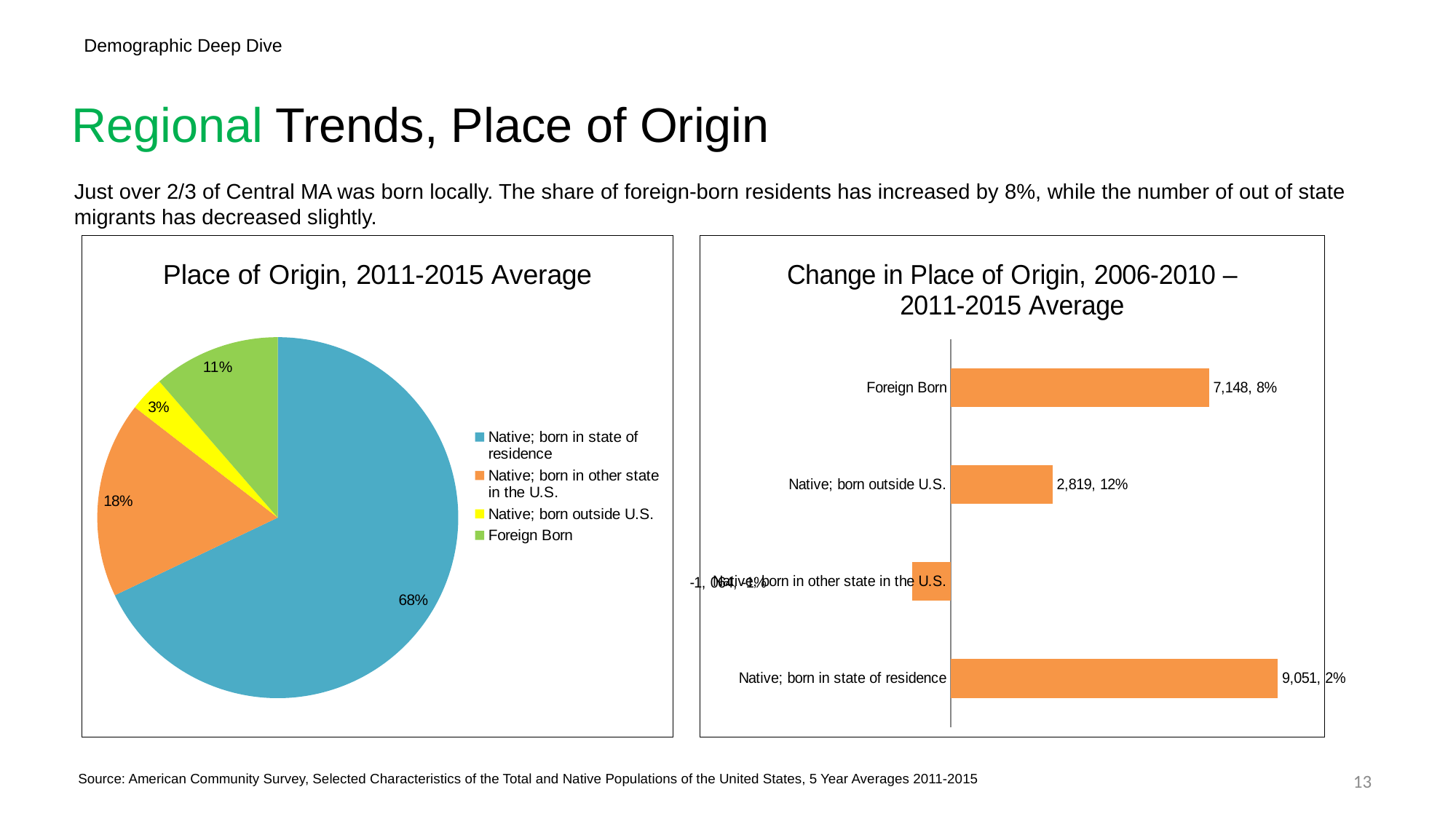
In the 'Place of Origin, 2011-2015 Average' chart, what share of the pie is 'Foreign Born'? 11% In the 'Change in Place of Origin, 2006-2010 – 2011-2015 Average' chart, what is the data label for 'Native; born in state of residence'? 9,051, 2% In the 'Change in Place of Origin, 2006-2010 – 2011-2015 Average' chart, what is the data label for 'Foreign Born'? 7,148, 8% In the 'Change in Place of Origin, 2006-2010 – 2011-2015 Average' chart, which category shows a negative change? Native; born in other state in the U.S. In the 'Place of Origin, 2011-2015 Average' chart, which category has the smallest slice? Native; born outside U.S. In the 'Place of Origin, 2011-2015 Average' chart, what share of the pie is 'Native; born outside U.S.'? 3% What kind of chart is 'Change in Place of Origin, 2006-2010 – 2011-2015 Average'? Bar chart In the 'Place of Origin, 2011-2015 Average' chart, what is the difference in percentage points between 'Native; born in other state in the U.S.' and 'Foreign Born'? 7 percentage points In the 'Place of Origin, 2011-2015 Average' chart, what share of the pie is 'Native; born in state of residence'? 68% What kind of chart is 'Place of Origin, 2011-2015 Average'? Pie chart In the 'Change in Place of Origin, 2006-2010 – 2011-2015 Average' chart, which category has the largest numeric change? Native; born in state of residence In the 'Place of Origin, 2011-2015 Average' chart, how many slices does the pie have? 4